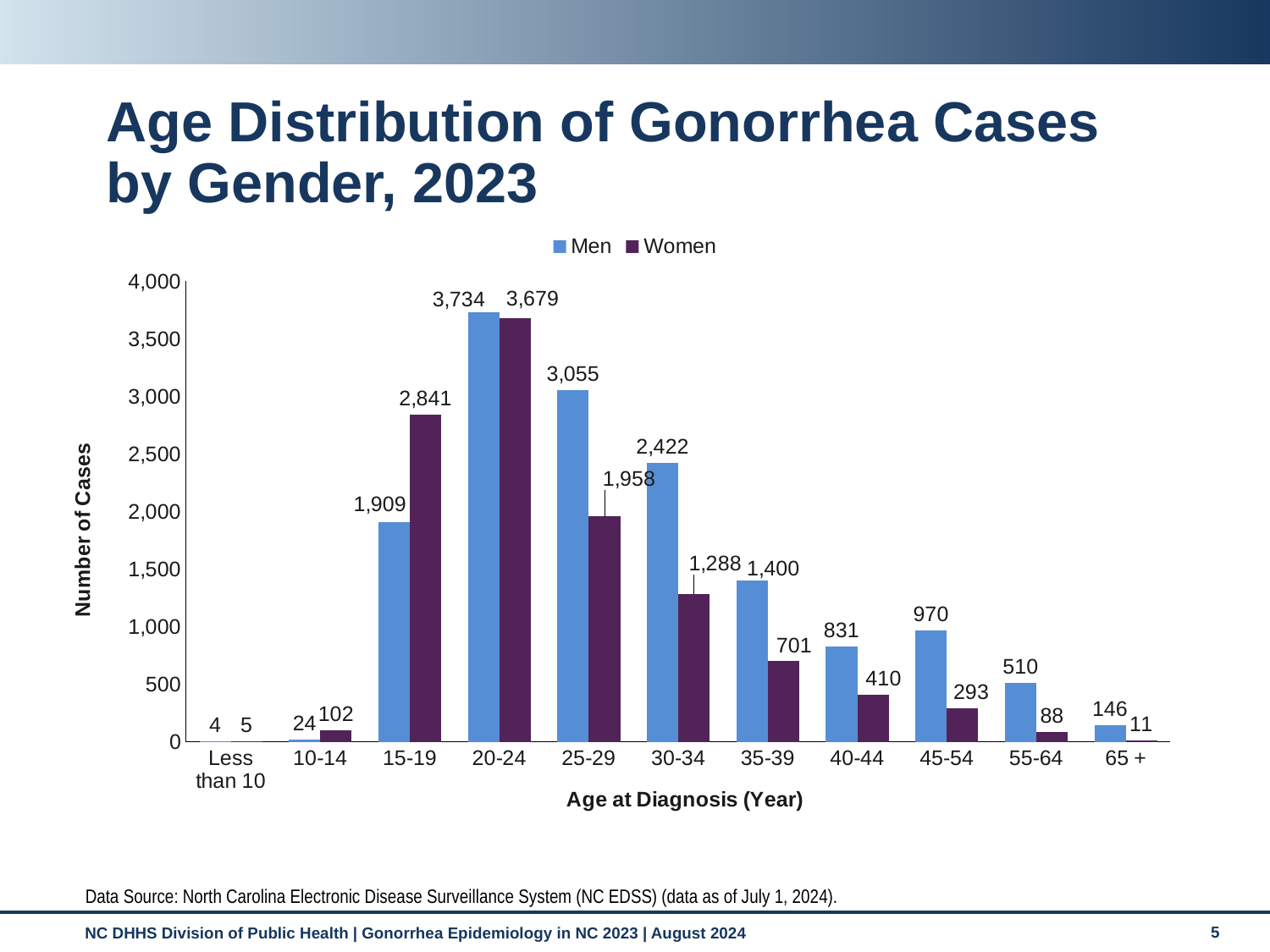
How many cases are shown for women aged 65 +? 11 What is the difference between the number of cases for men and women in the 35-39 age group? 699 What kind of chart is shown on the slide? Bar chart What is the number of cases for women in the 15-19 age group? 2,841 From the 20-24 age group to the 65 + age group, do the values for women rise or fall? Fall In the 45-54 age group, which gender has more cases, men or women? Men In the 25-29 age group, how many more cases are there for men than for women? 1,097 Which age group has the lowest number of cases among women? Less than 10 How many gonorrhea cases were reported among men aged 20-24? 3,734 How many age groups are shown on the x axis? 11 How many series does the legend list? 2 Which age group has the highest number of cases among men? 20-24